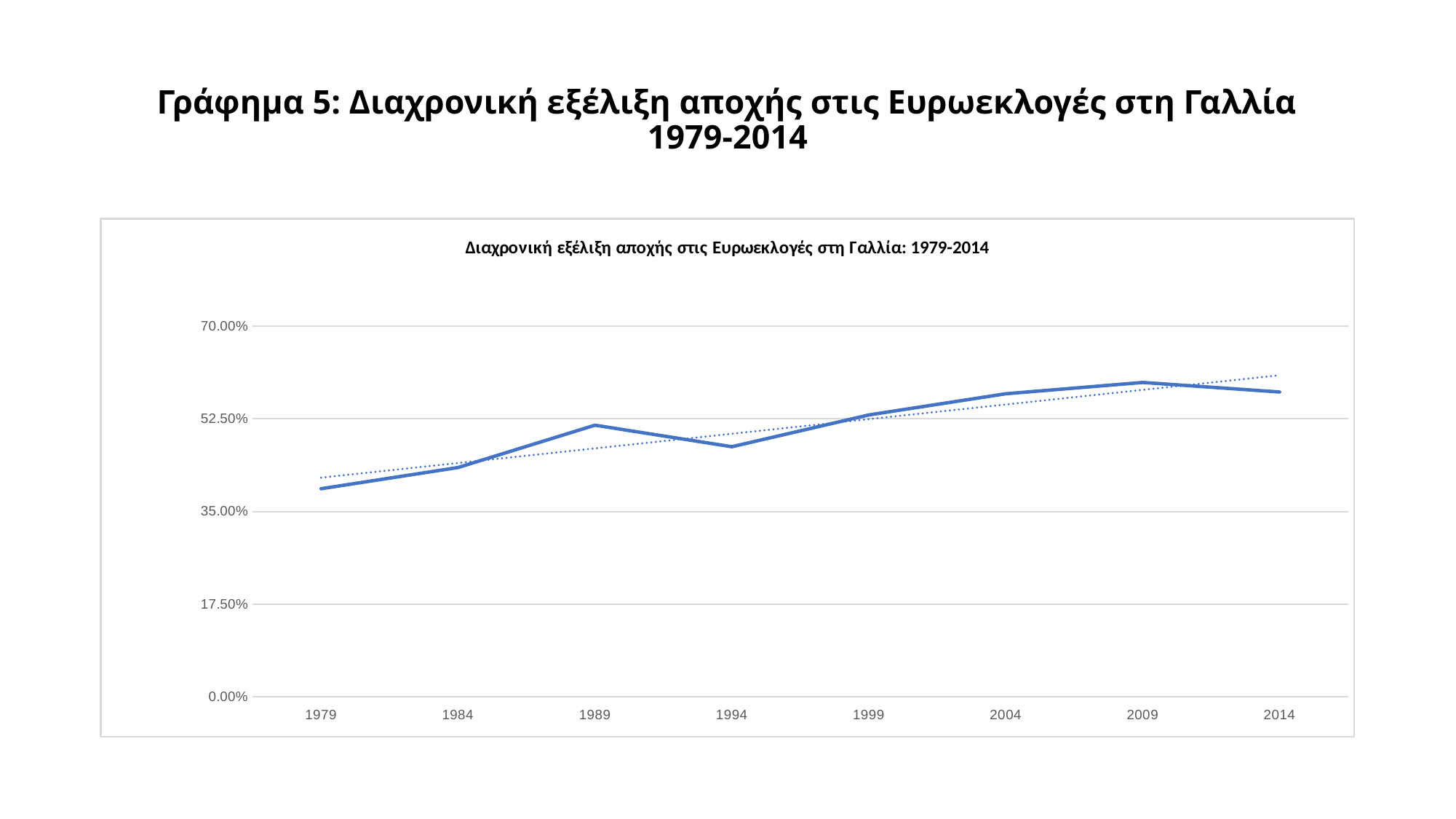
How many years are plotted along the x axis? 8 What is the title shown inside the chart area? Διαχρονική εξέλιξη αποχής στις Ευρωεκλογές στη Γαλλία: 1979-2014 Is the value for 1994 greater or less than 52.50%? less Which year has the highest abstention value? 2009 Which year has the larger value, 1989 or 1994? 1989 Is the value for 1979 greater or less than 35.00%? greater Is the value for 2009 greater or less than 70.00%? less Which year has the lowest abstention value? 1979 Overall, do the values rise or fall from 1979 to 2014? rise What kind of chart is shown on the slide? line chart